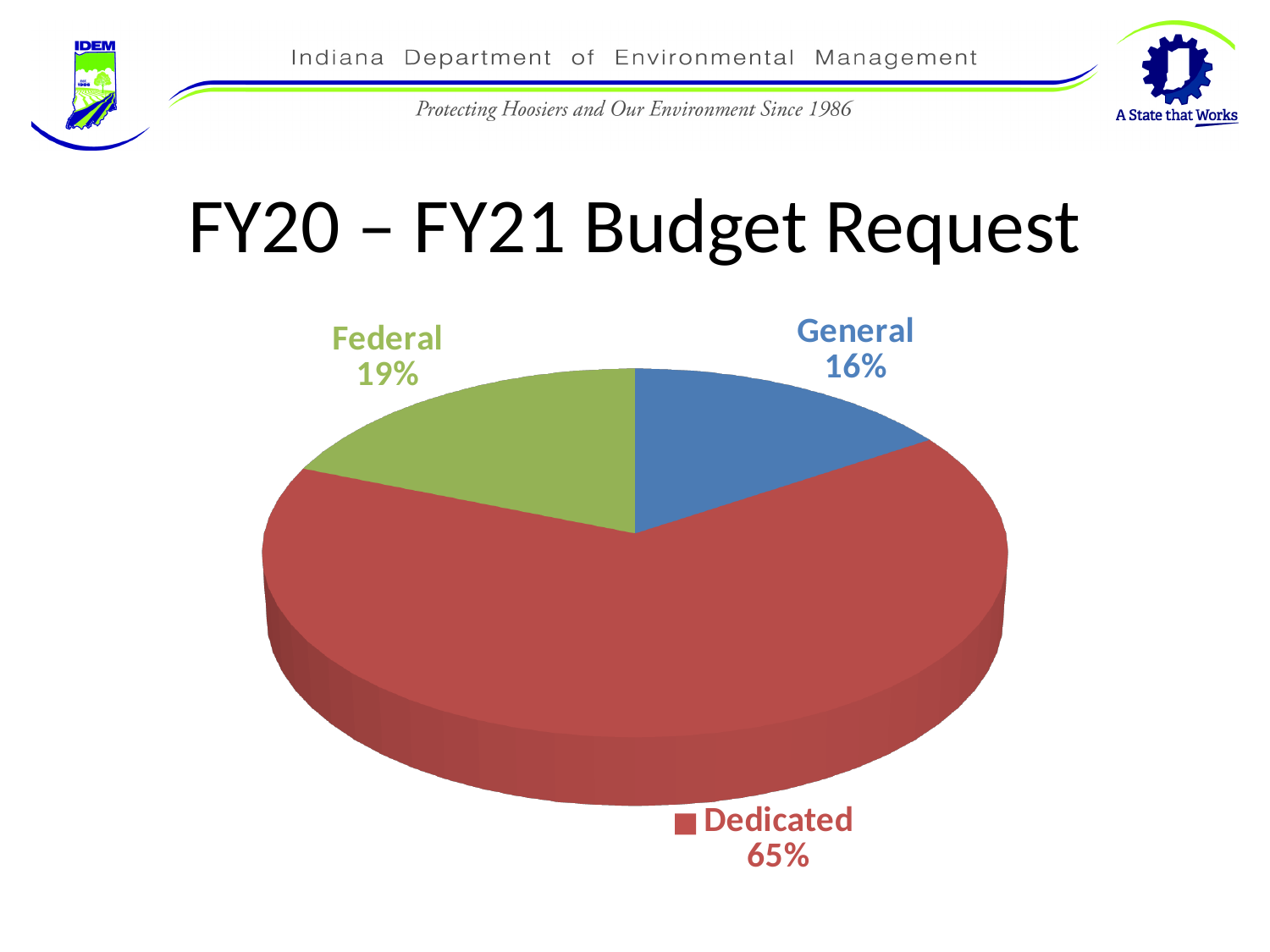
What is the difference in percentage points between the Federal and General shares? 3 What colour is the Dedicated slice of the pie chart? Red What share of the budget request is Federal? 19% What is the title of the slide containing the chart? FY20 – FY21 Budget Request Which funding source has the smallest share of the budget request? General What kind of chart is shown on the slide? Pie chart What is the difference in percentage points between the Dedicated and Federal shares? 46 What share of the budget request is Dedicated? 65% How many funding categories are shown in the pie chart? 3 Which funding source has the largest share of the budget request? Dedicated Which is larger, the Federal share or the General share? Federal What share of the budget request is General? 16%